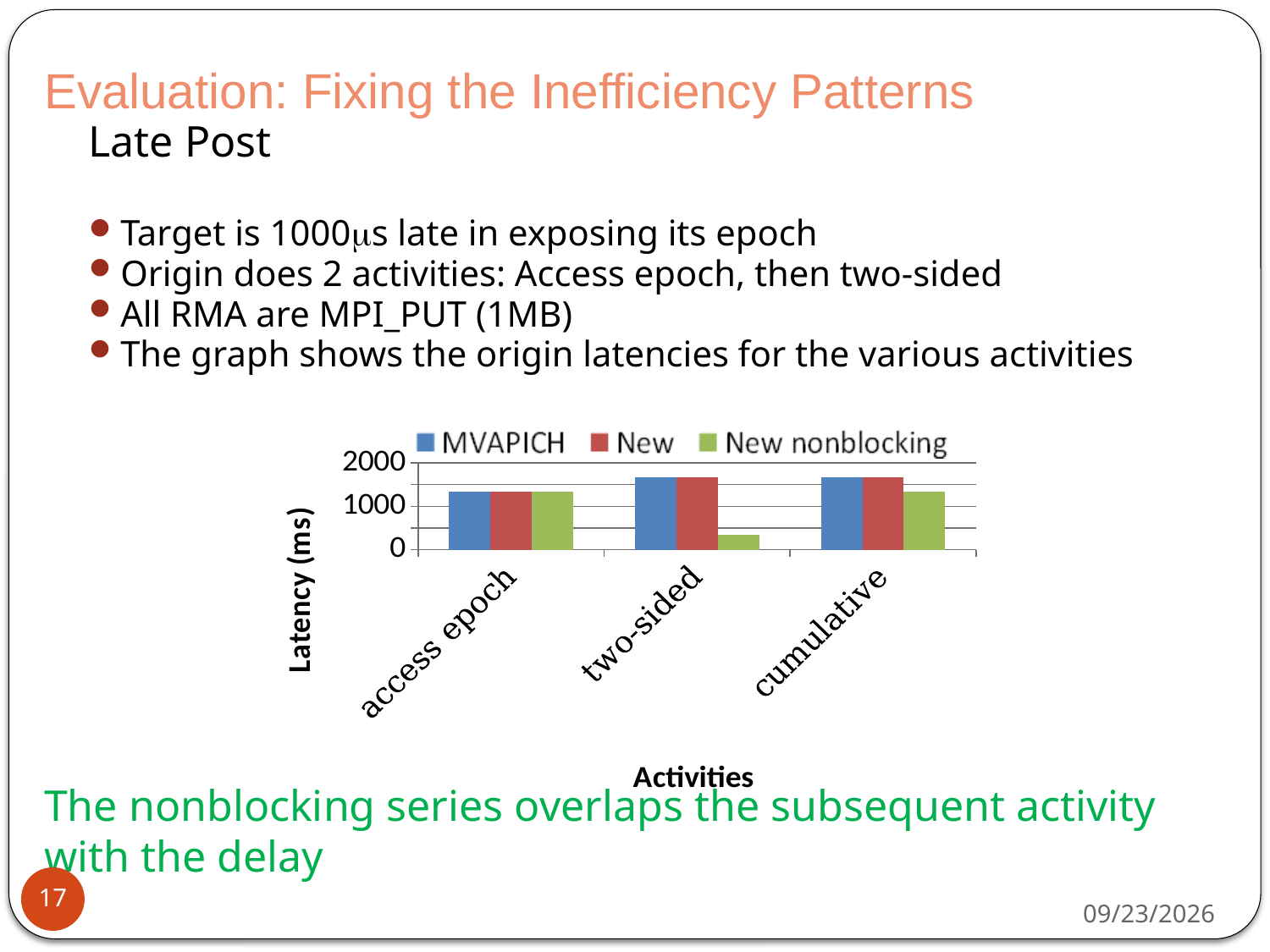
How many series does the chart's legend list? 3 For the cumulative activity, which is larger: the New value or the New nonblocking value? New Is the New nonblocking value for access epoch greater or less than 1000? greater For the two-sided activity, which is larger: the MVAPICH value or the New nonblocking value? MVAPICH Is the New value for cumulative greater or less than 2000? less Which series are listed in the chart's legend? MVAPICH, New, New nonblocking What is the title of the chart's y axis? Latency (ms) Is the New nonblocking value for two-sided greater or less than 1000? less How many activity categories are shown on the x axis of the chart? 3 What kind of chart is shown on the slide? bar chart For the New nonblocking series, which activity has the lowest latency? two-sided